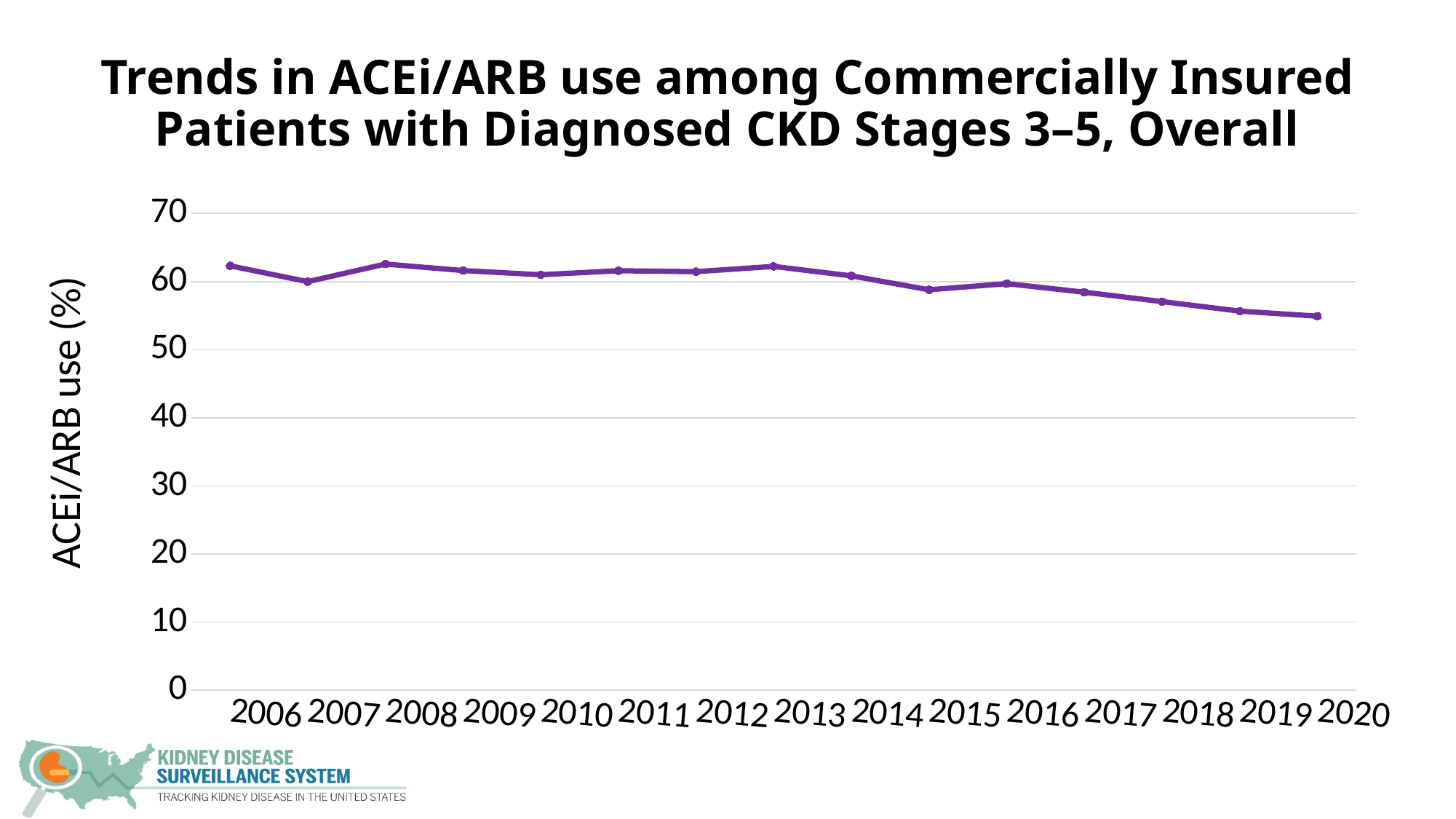
Is the value for 2013 greater or less than 50? greater Is the value for 2019 greater or less than 60? less Overall, does ACEi/ARB use rise or fall from 2006 to 2020? fall Which year has the higher ACEi/ARB use, 2006 or 2020? 2006 Which year has the higher ACEi/ARB use, 2013 or 2019? 2013 What kind of chart is shown on the slide? line chart Is the value for 2020 greater or less than 60? less What is the label on the vertical axis of the chart? ACEi/ARB use (%) How many years (data points) are plotted on the chart? 15 Which year has the lowest ACEi/ARB use on the chart? 2020